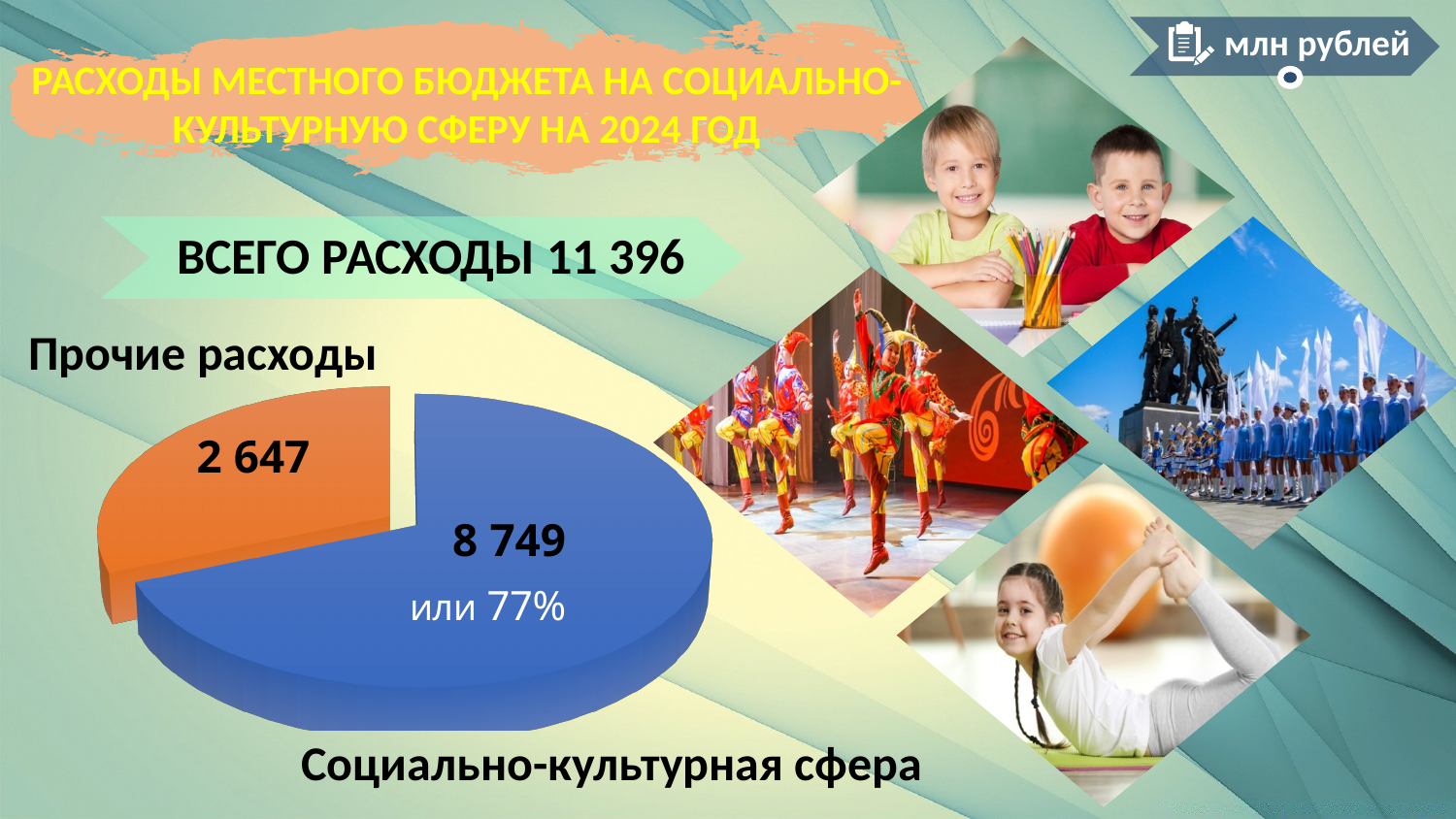
What is the total of all expenditures shown on the slide (ВСЕГО РАСХОДЫ)? 11 396 How many slices does the pie chart have? 2 What is the difference between Социально-культурная сфера and Прочие расходы? 6 102 Which is larger, Социально-культурная сфера or Прочие расходы? Социально-культурная сфера Which slice of the pie chart is the smallest? Прочие расходы What is the value for Прочие расходы in the pie chart? 2 647 What colour is the Прочие расходы slice of the pie chart? orange Which slice of the pie chart is the largest? Социально-культурная сфера What is the value for Социально-культурная сфера in the pie chart? 8 749 What kind of chart is shown on the slide? pie chart In what units are the values on the slide given? млн рублей What share of the pie does Социально-культурная сфера represent? 77%